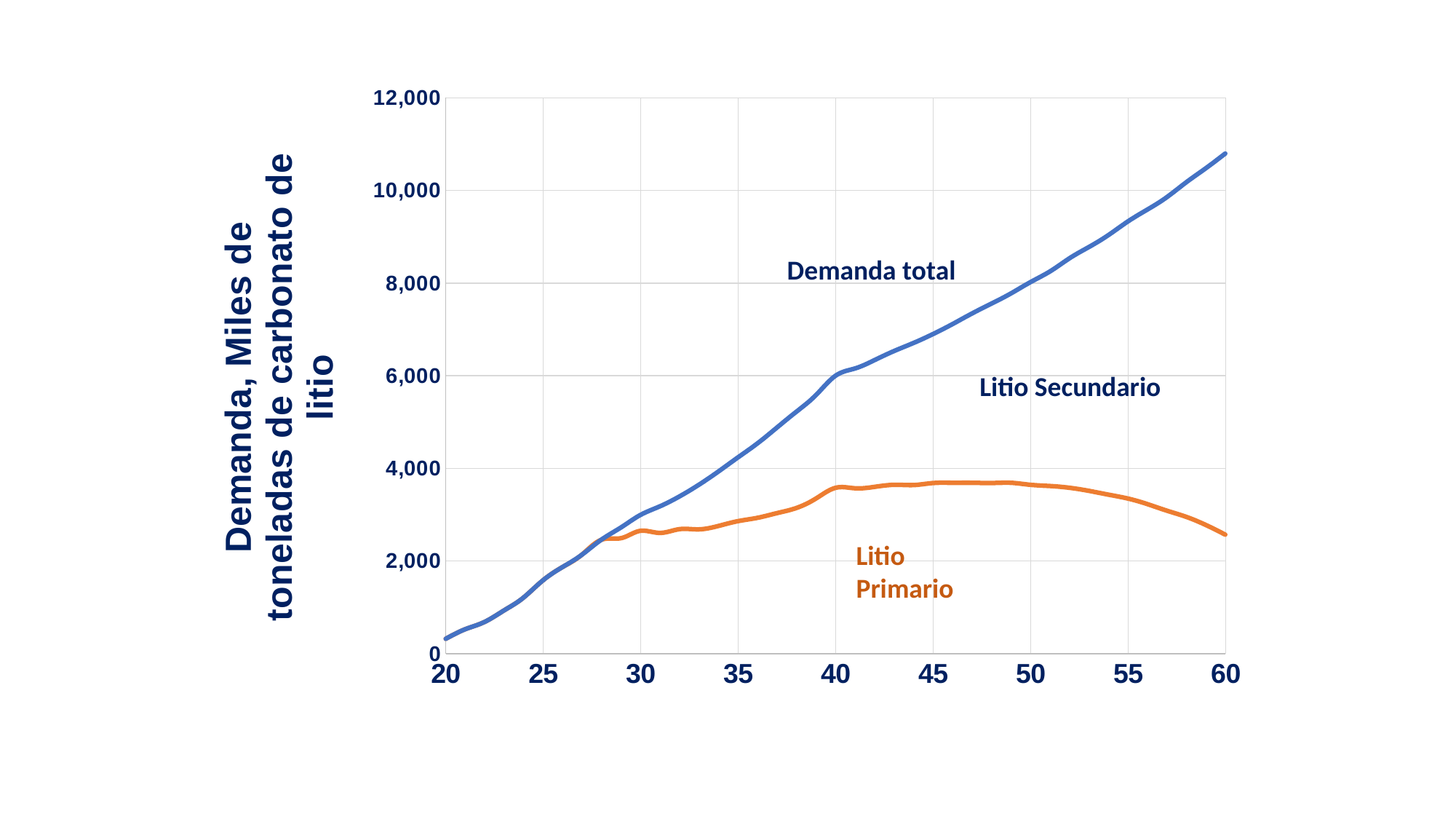
What is the title of the vertical axis? Demanda, Miles de toneladas de carbonato de litio What kind of chart is shown on the slide? line chart Is the value of Litio Primario at 60 greater or less than 2,000? greater Does the Litio Primario line rise or fall between 50 and 60? falls Is the value of Demanda total at 20 greater or less than 2,000? less Is the value of Litio Primario at 45 greater or less than 4,000? less Does the Demanda total line rise or fall from 20 to 60? rises What label is placed in the gap between the Demanda total line and the Litio Primario line? Litio Secundario How many lines are plotted on the chart? 2 At 60, which is larger: Demanda total or Litio Primario? Demanda total